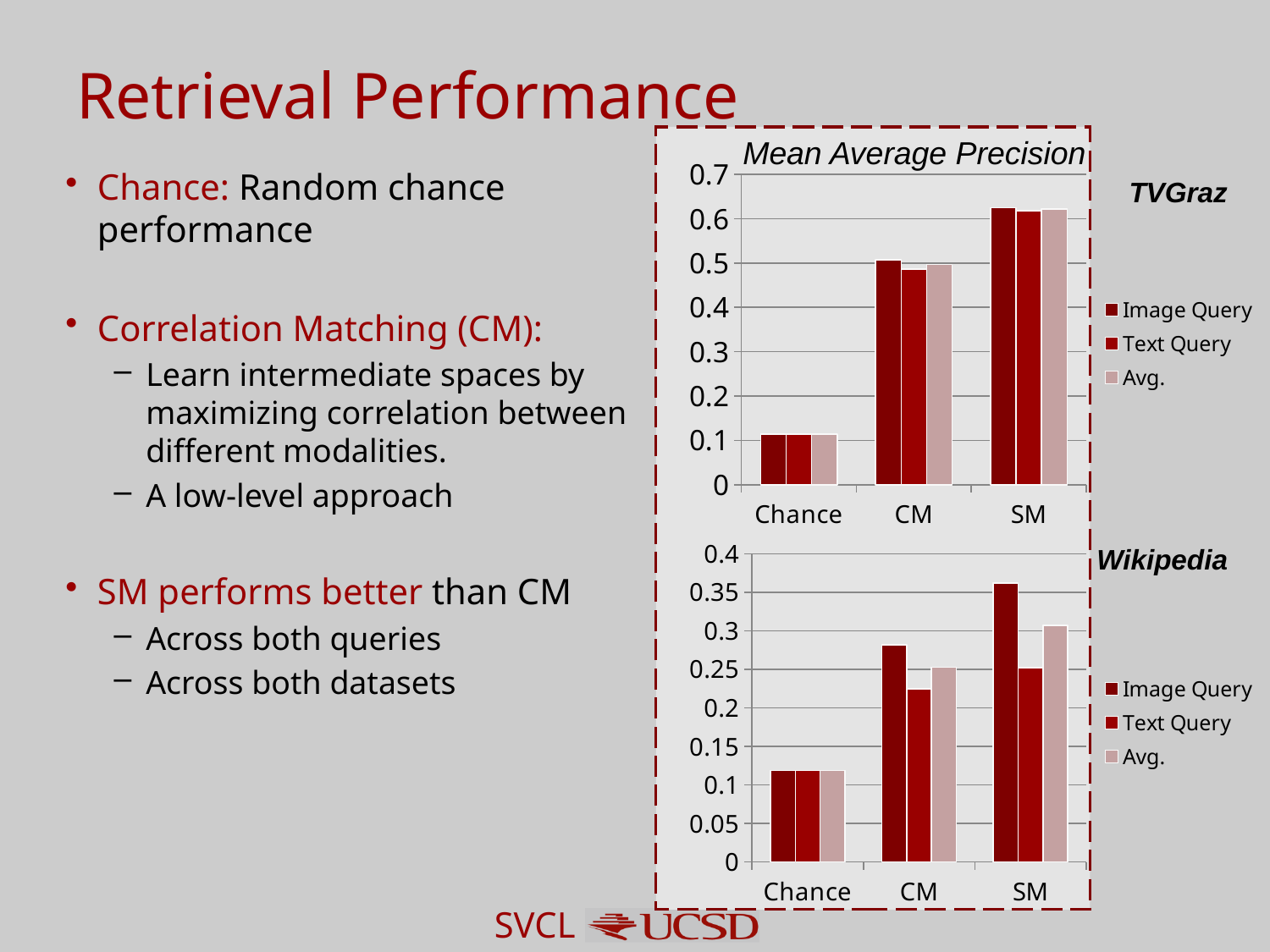
How many categories are shown on the x axis of the TVGraz chart? 3 What kind of chart is the TVGraz chart? bar chart In the TVGraz chart, which category has the lowest Avg. value? Chance In the TVGraz chart, which category has the highest Image Query value? SM In the Wikipedia chart, is the Image Query value for SM greater or less than 0.3? greater In the Wikipedia chart, do the Image Query values rise or fall from Chance to SM along the x axis? rise What is the title of the top chart? Mean Average Precision In the Wikipedia chart, is the Text Query value for SM greater or less than 0.3? less In the TVGraz chart, is the Text Query value for Chance greater or less than 0.2? less In the Wikipedia chart, which is larger for CM: the Image Query value or the Text Query value? Image Query How many series does the legend of the Wikipedia chart list? 3